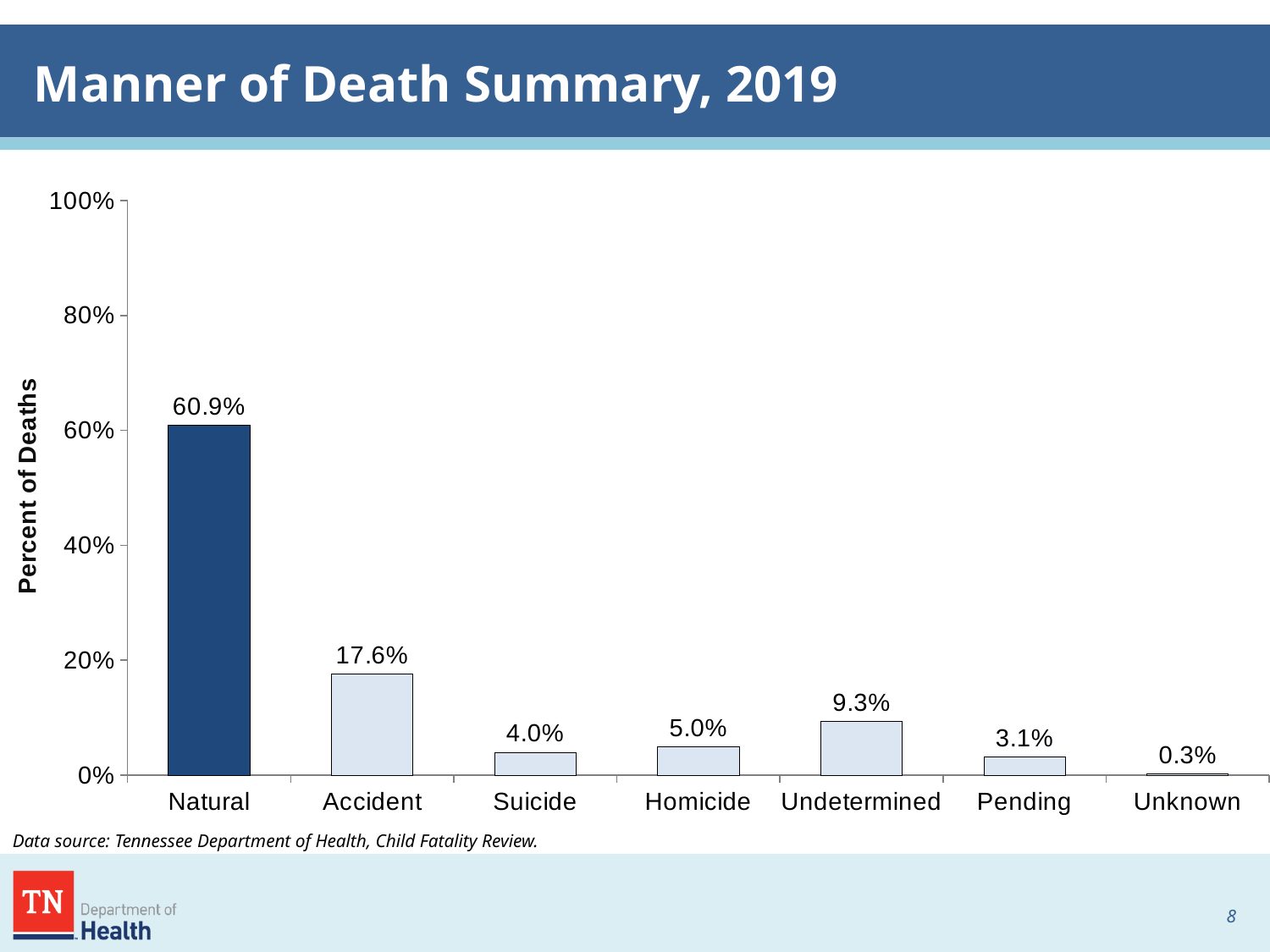
What kind of chart is shown on the slide? Bar chart How many manner-of-death categories are shown on the chart? 7 Is the value for Natural greater or less than 60%? greater What percent of deaths were Natural? 60.9% Which manner of death has the lowest percent of deaths? Unknown What is the value for Undetermined? 9.3% What percent of deaths were Accident? 17.6% Which manner of death has the highest percent of deaths? Natural What is the value for Unknown? 0.3% Which is larger, Suicide or Homicide? Homicide What is the difference between the Natural and Accident percentages? 43.3% What is the label of the y axis? Percent of Deaths